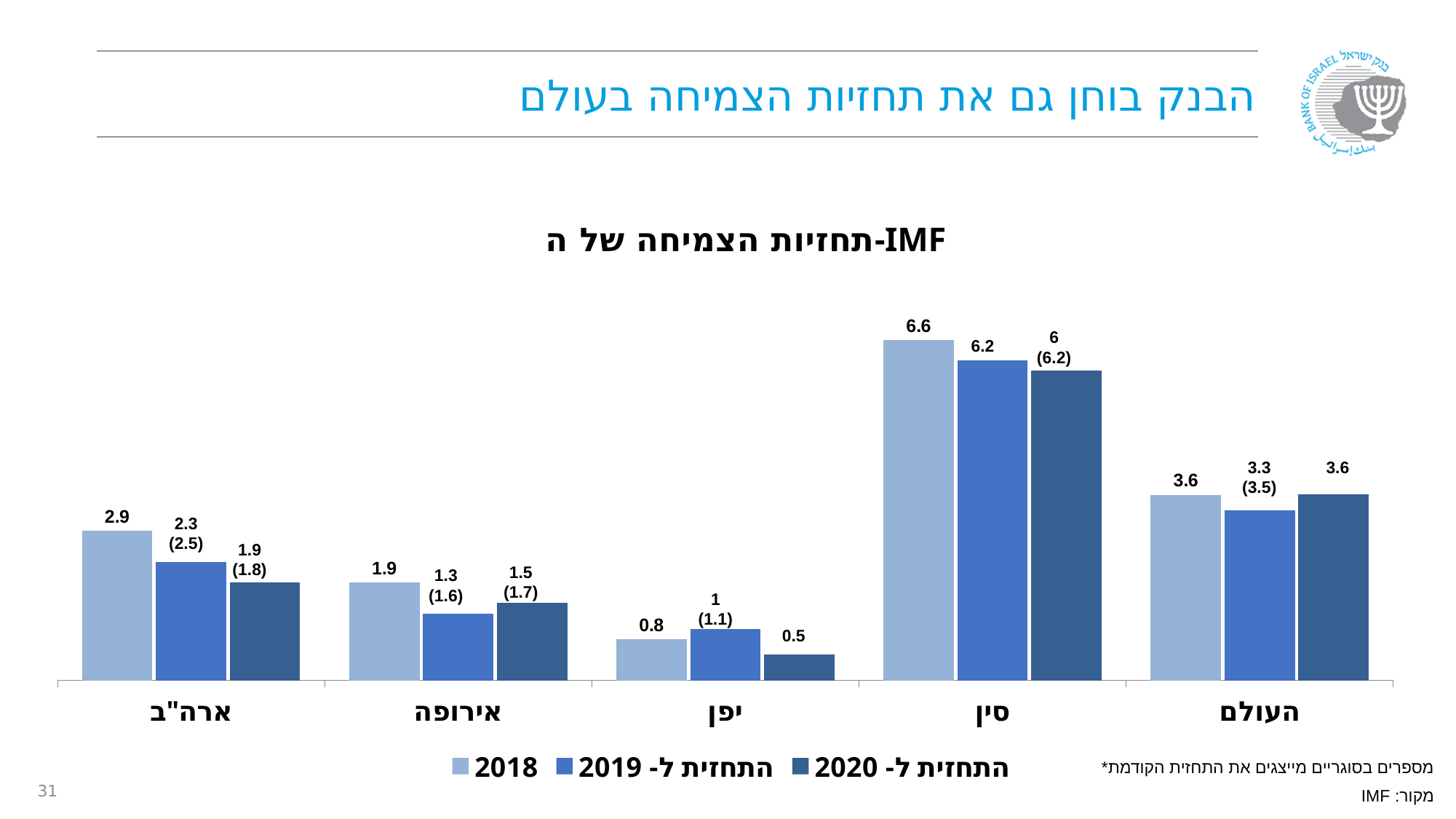
What is the value of the התחזית ל-2020 (forecast for 2020) series for יפן (Japan)? 0.5 What is the value of the התחזית ל-2019 (forecast for 2019) series for ארה"ב (USA)? 2.3 What is the difference between the 2018 value and the התחזית ל-2020 (forecast for 2020) value for ארה"ב (USA)? 1 Which category has the lowest value in the התחזית ל-2020 (forecast for 2020) series? יפן (Japan) What is the value shown in parentheses under the התחזית ל-2019 (forecast for 2019) label for העולם (World)? 3.5 What kind of chart is shown on the slide? Bar chart What is the 2018 value for סין (China)? 6.6 How many series does the legend list? 3 Which is larger for אירופה (Europe): the התחזית ל-2019 (forecast for 2019) value or the התחזית ל-2020 (forecast for 2020) value? התחזית ל-2020 (forecast for 2020) Which category has the highest 2018 value? סין (China) What is the 2018 value for העולם (World)? 3.6 How many categories are shown on the x axis? 5